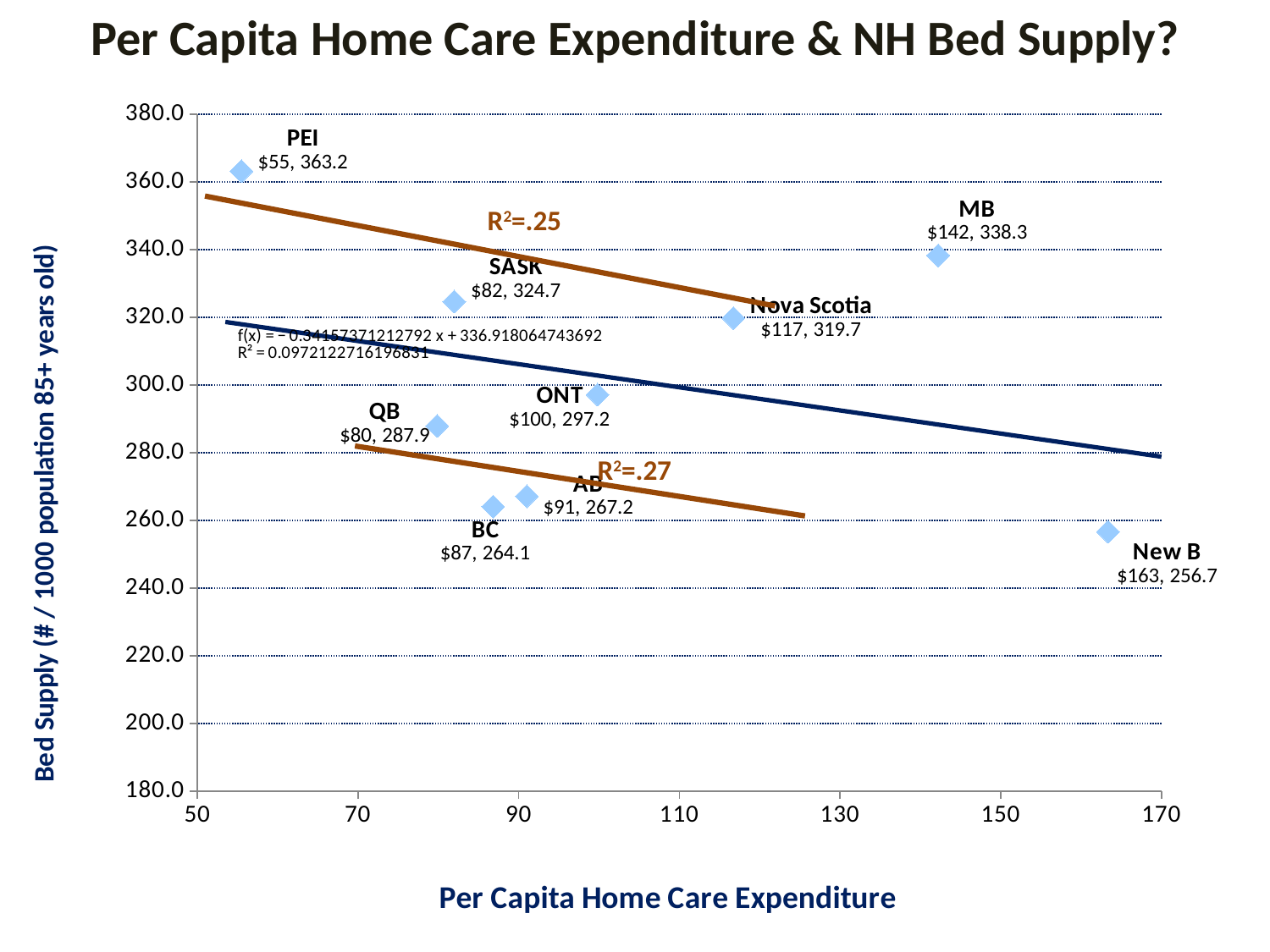
What is the difference in bed supply between MB and Nova Scotia? 18.6 What kind of chart is shown on the slide? scatter chart Do bed supply values generally rise or fall as per capita home care expenditure increases, according to the trend lines? fall What is the per capita home care expenditure for New B? $163 What is the label of the x axis? Per Capita Home Care Expenditure What is the bed supply value for PEI? 363.2 Which province has the highest bed supply? PEI Which province has the lowest bed supply? New B How many provinces are plotted on the chart? 9 What is the bed supply value for Nova Scotia? 319.7 Which has a higher bed supply, QB or ONT? ONT What is the per capita home care expenditure for MB? $142